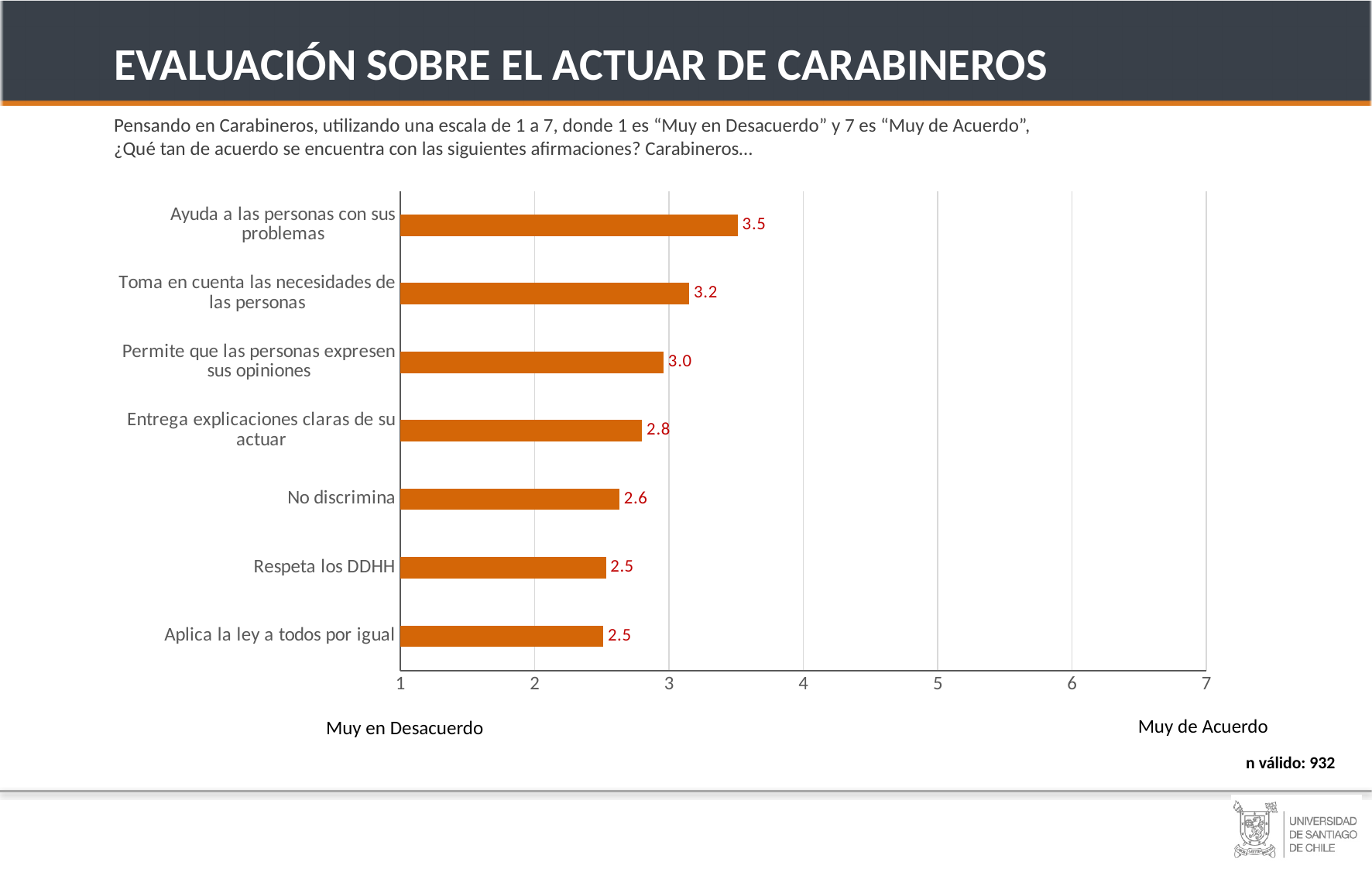
What label appears at the right end of the scale, under the value 7? Muy de Acuerdo What kind of chart is shown on the slide? bar chart What is the difference between the values for "Toma en cuenta las necesidades de las personas" and "Permite que las personas expresen sus opiniones"? 0.2 What is the value for "Entrega explicaciones claras de su actuar"? 2.8 Which is larger, the value for "Toma en cuenta las necesidades de las personas" or the value for "No discrimina"? Toma en cuenta las necesidades de las personas Which statement has the highest value? Ayuda a las personas con sus problemas What is the value for "No discrimina"? 2.6 What is the valid sample size (n válido) shown on the slide? 932 Is the value for "Ayuda a las personas con sus problemas" greater or less than 4? less What is the value for "Ayuda a las personas con sus problemas"? 3.5 How many statements are shown in the chart? 7 What is the difference between the values for "Ayuda a las personas con sus problemas" and "Aplica la ley a todos por igual"? 1.0